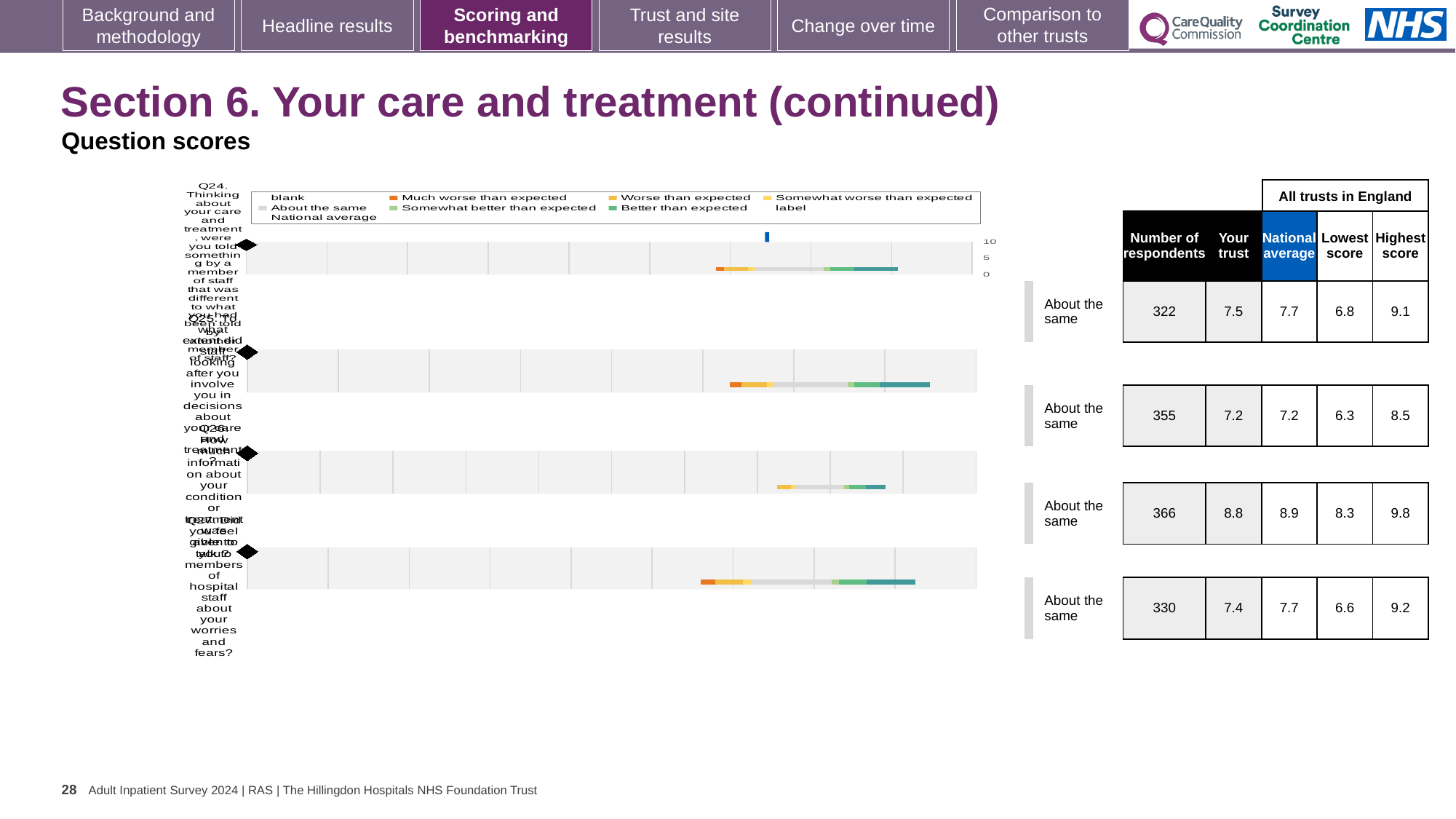
What benchmark category is shown beside each of the four question rows? About the same In the table beside the chart, which row has the lowest number of respondents? Q24 (first row), 322 What kind of chart is shown on the left of the slide? bar chart In the table beside the chart, what is the difference between the highest score and the lowest score for the first row (Q24)? 2.3 In the table beside the chart, what is the national average for the fourth row (Q27)? 7.7 In the table beside the chart, what is the number of respondents for the third row (Q26)? 366 In the table beside the chart, what is the 'Your trust' score for the first row (Q24)? 7.5 In the table beside the chart, is the 'Your trust' score larger for the second row (Q25) or the third row (Q26)? Q26 (third row) In the table beside the chart, which row has the highest 'Your trust' score? Q26 (third row), 8.8 How many question rows (categories) does the chart on the left show? 4 How many entries does the legend of the chart list? 9 In the chart's legend, which category is shown in dark orange? Much worse than expected